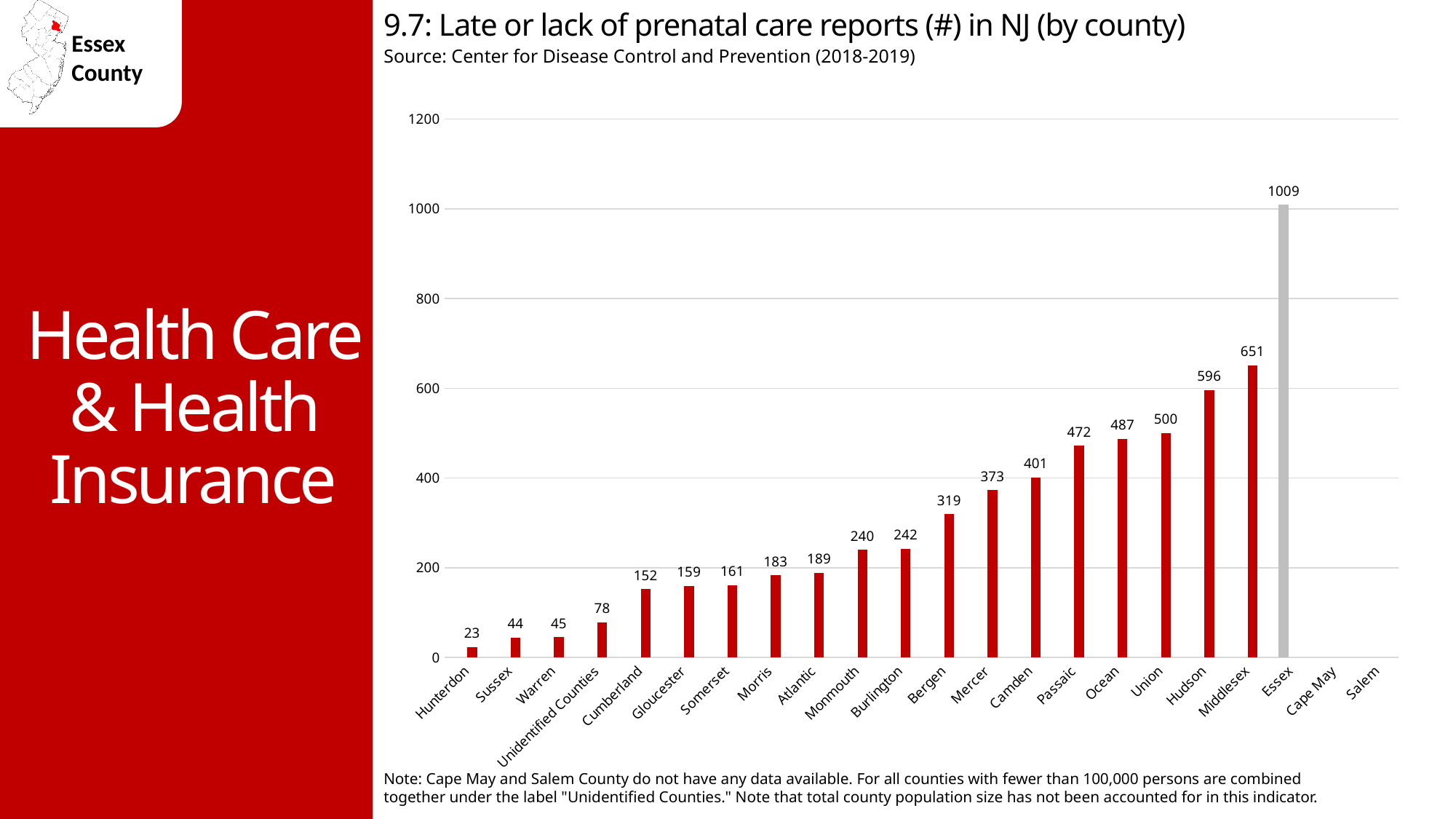
What is the number of late or lack of prenatal care reports for Essex County? 1009 What is the value shown for Hudson County? 596 How many counties are labeled on the x axis, including Unidentified Counties? 22 Which county with a plotted bar has the lowest number of reports? Hunterdon What is the difference between the values for Essex and Middlesex? 358 What is the difference between the values for Bergen and Mercer? 54 Which two counties on the x axis have no bar because no data is available? Cape May and Salem Which has a higher value, Passaic or Camden? Passaic Is the value for Union greater or less than 400? greater What type of chart is shown on the slide? Bar chart Which county has the highest number of late or lack of prenatal care reports? Essex What is the value shown for Unidentified Counties? 78